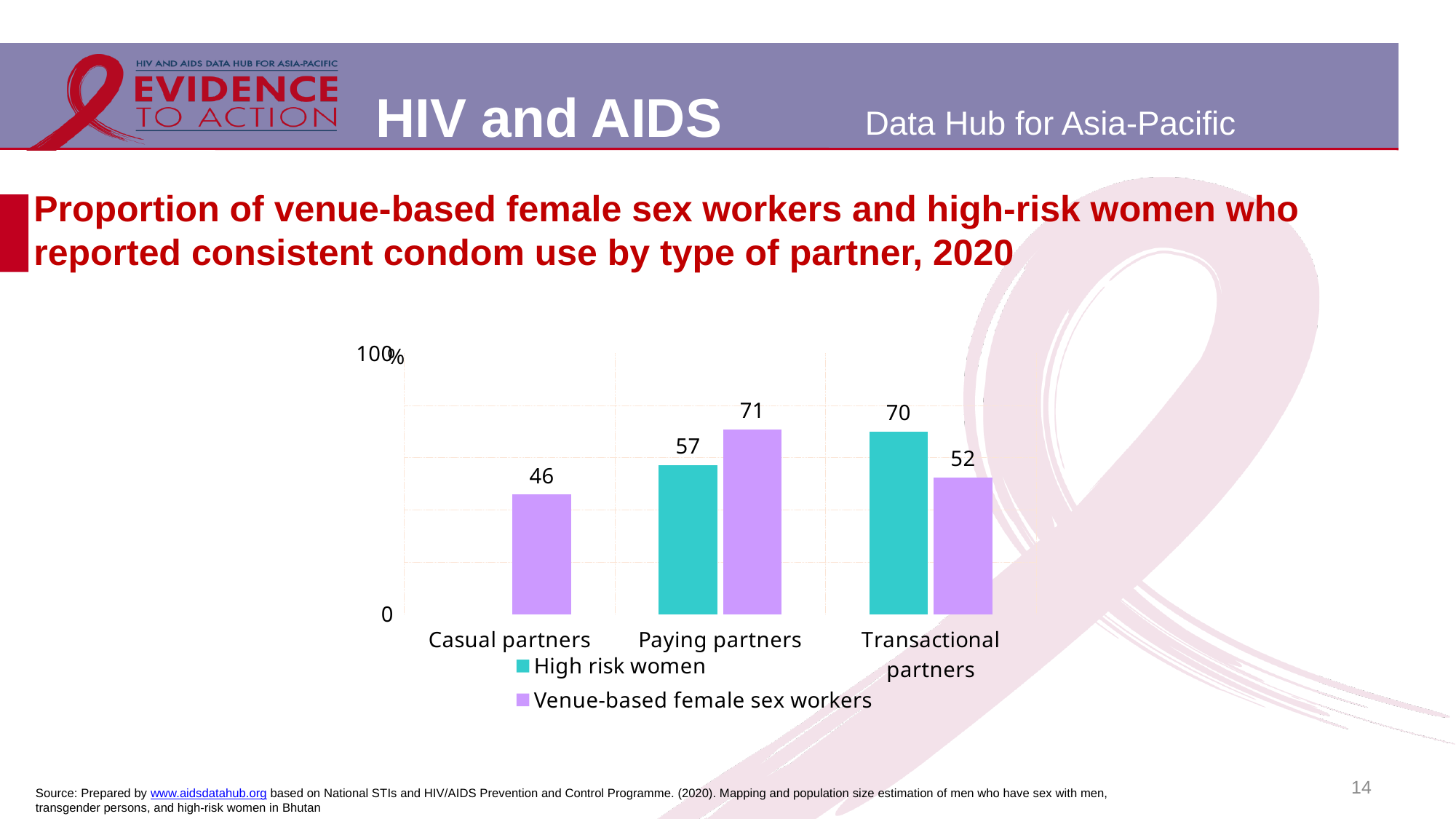
How many partner-type categories are shown on the x axis? 3 Which partner type has the lowest value for Venue-based female sex workers? Casual partners Which partner type has the highest value for Venue-based female sex workers? Paying partners How many series does the legend list? 2 What is the value for High risk women for Paying partners? 57 What is the value for Venue-based female sex workers for Transactional partners? 52 What is the value for High risk women for Transactional partners? 70 Which colour represents High risk women in the chart? Teal What kind of chart is shown on the slide? Bar chart What is the value for Venue-based female sex workers for Casual partners? 46 What is the difference between the Venue-based female sex workers and High risk women values for Paying partners? 14 For Transactional partners, which series has the larger value: High risk women or Venue-based female sex workers? High risk women